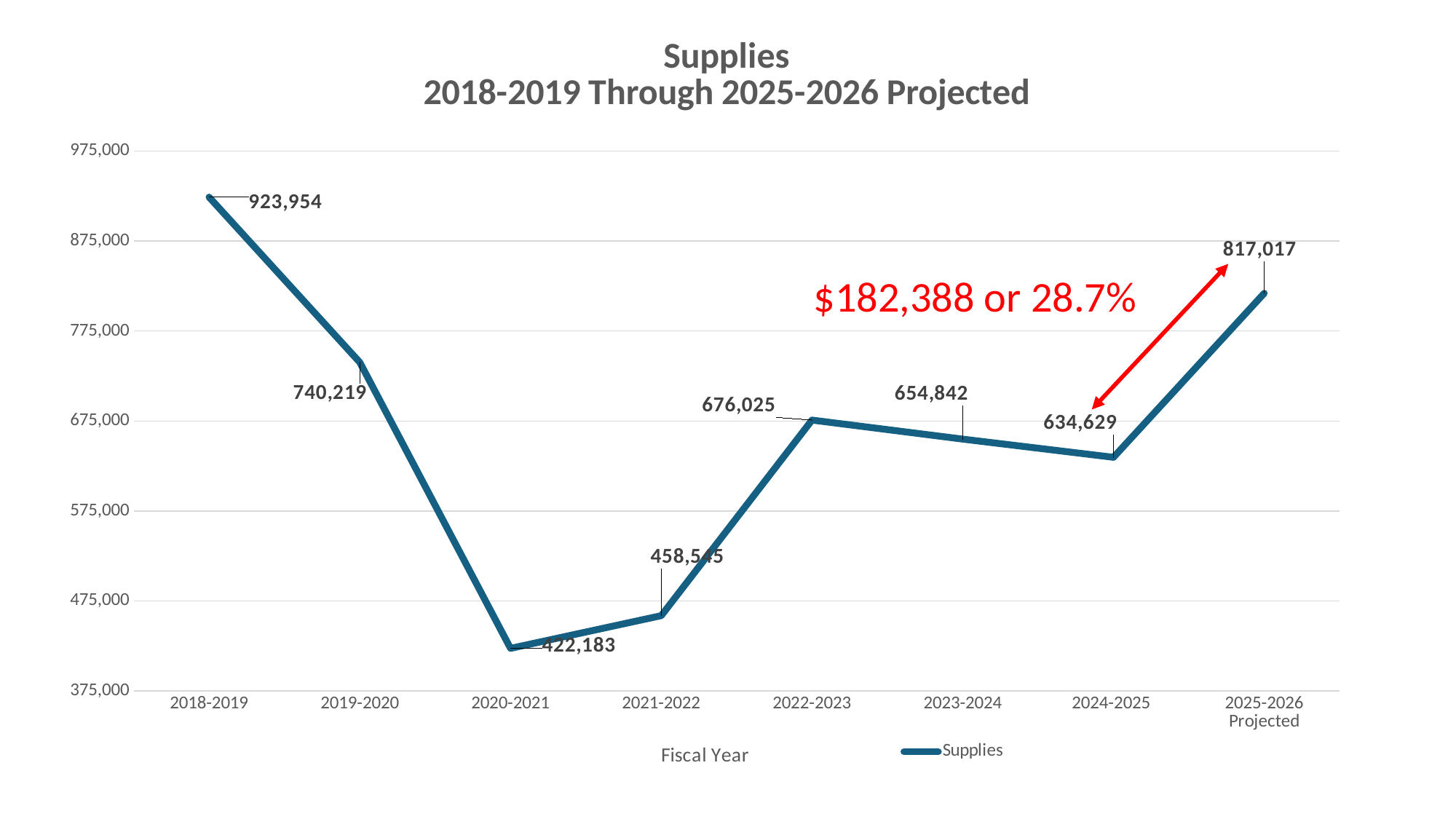
What is the projected Supplies value for 2025-2026? 817,017 How many fiscal years are plotted on the chart? 8 What is the Supplies value for 2018-2019? 923,954 Is the Supplies value for 2021-2022 greater or less than 475,000? less Which fiscal year has the highest Supplies value? 2018-2019 What is the Supplies value for 2020-2021? 422,183 What kind of chart is shown on the slide? line chart Which fiscal year has the lowest Supplies value? 2020-2021 What is the Supplies value for 2023-2024? 654,842 What is the difference between the Supplies values for 2025-2026 Projected and 2024-2025? 182,388 What percentage increase is annotated in red on the chart? 28.7% Which is larger, the Supplies value for 2022-2023 or for 2023-2024? 2022-2023